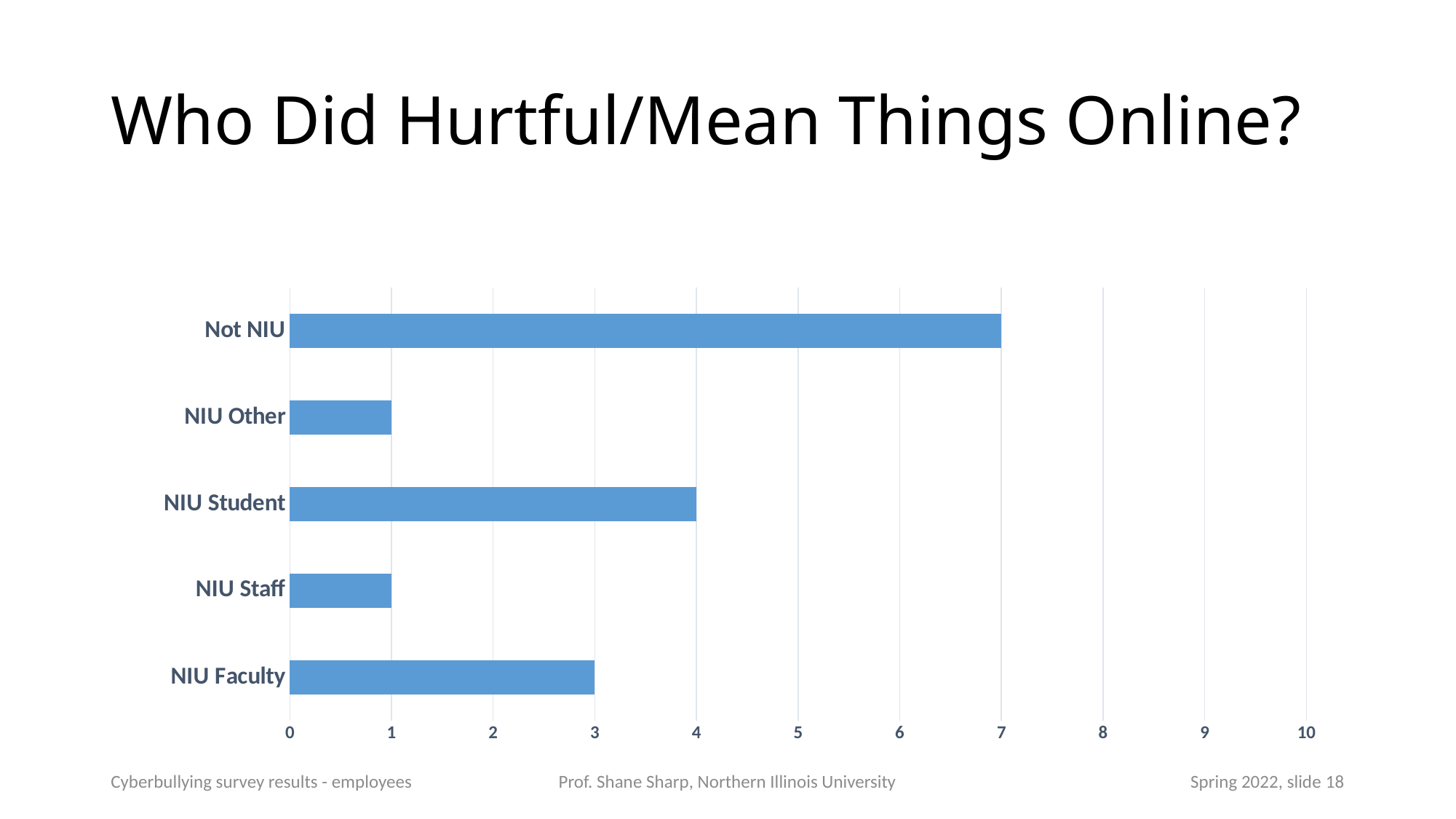
What is the value for NIU Other? 1 What is the title of the slide? Who Did Hurtful/Mean Things Online? Which is larger, the value for NIU Faculty or the value for NIU Staff? NIU Faculty What kind of chart is shown on the slide? bar chart How many categories are shown in the chart? 5 What is the difference between the values for Not NIU and NIU Student? 3 Is the value for Not NIU greater or less than 5? greater What is the value for Not NIU? 7 What is the value for NIU Faculty? 3 Which category has the highest value? Not NIU What is the difference between the values for NIU Student and NIU Faculty? 1 What is the value for NIU Student? 4